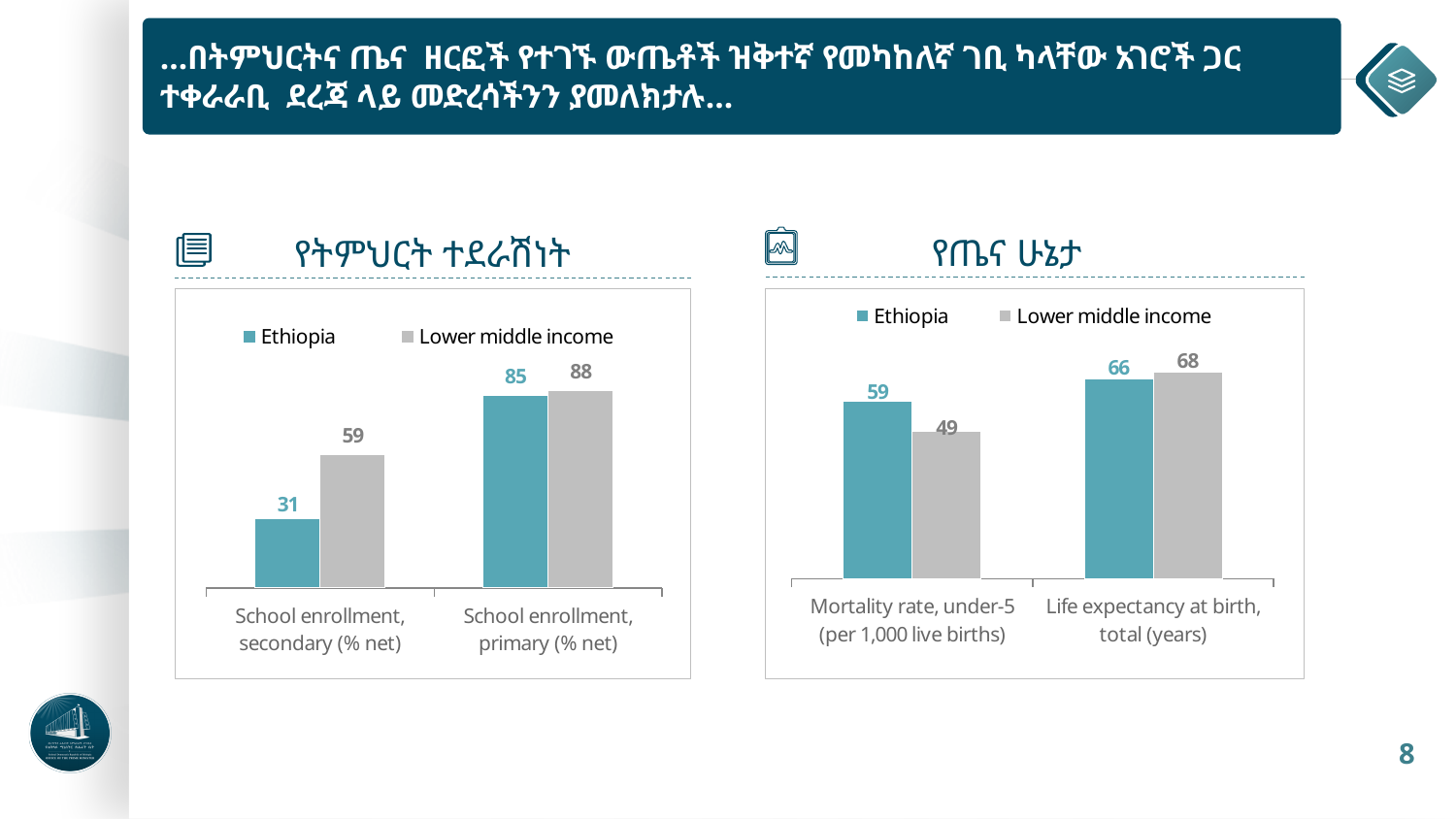
In the right chart, which colour represents Ethiopia in the legend? Teal (blue-green) In the left chart, how many categories are shown on the x axis? 2 In the left chart, what is the value for Ethiopia for School enrollment, secondary (% net)? 31 What kind of chart is the right chart? Bar chart In the left chart, what is the difference between Lower middle income and Ethiopia for School enrollment, secondary (% net)? 28 In the left chart, which series has the higher value for School enrollment, primary (% net)? Lower middle income In the right chart, what is the value for Ethiopia for Mortality rate, under-5 (per 1,000 live births)? 59 In the right chart, what is the difference between Lower middle income and Ethiopia for Life expectancy at birth, total (years)? 2 In the left chart, how many series does the legend list? 2 In the right chart, which series has the higher value for Mortality rate, under-5 (per 1,000 live births)? Ethiopia In the left chart, what is the value for Lower middle income for School enrollment, primary (% net)? 88 In the right chart, what is the value for Lower middle income for Life expectancy at birth, total (years)? 68